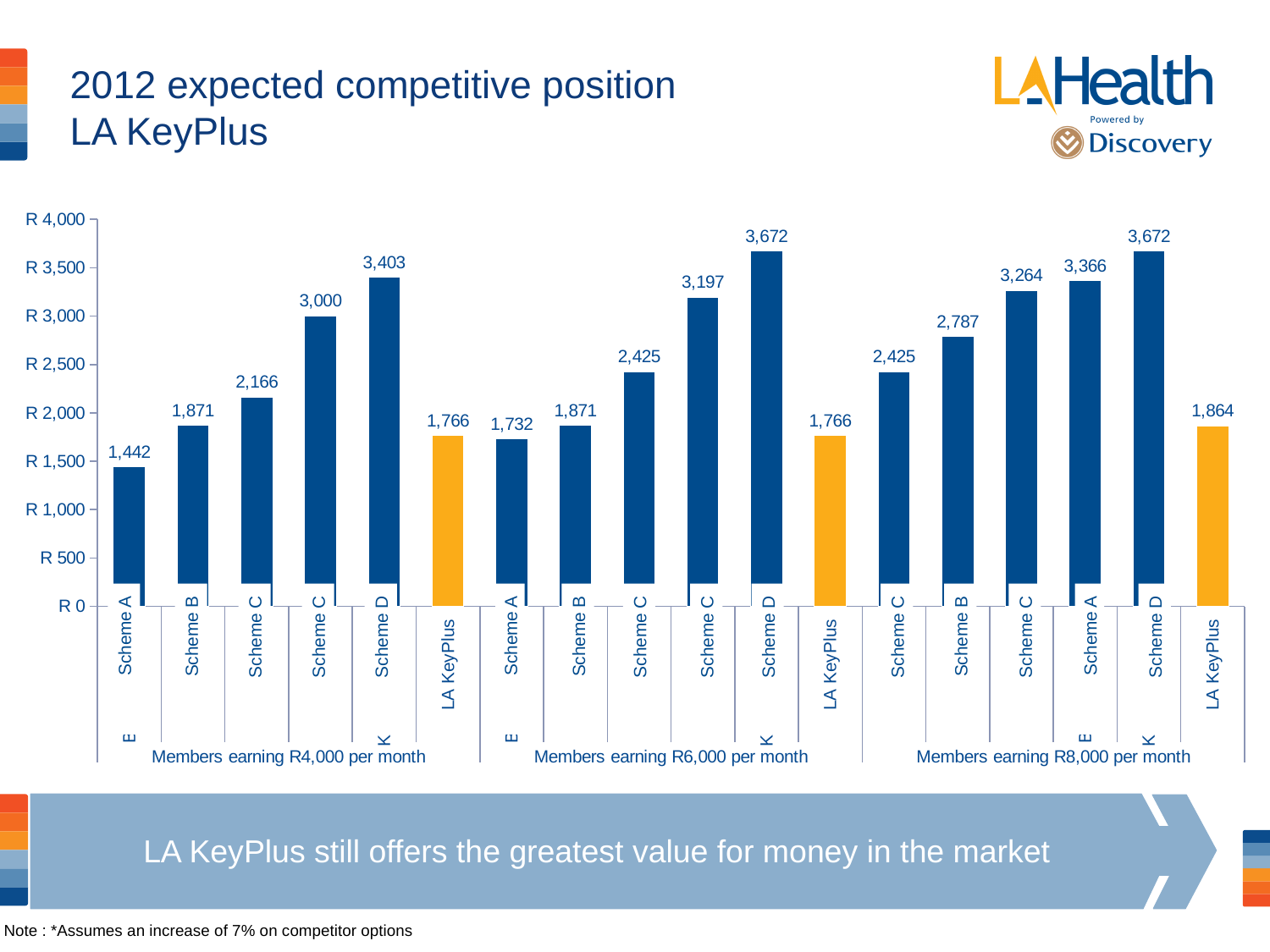
In the 'Members earning R8,000 per month' group, which is larger: Scheme B or LA KeyPlus? Scheme B Which bar has the lowest value in the whole chart? Scheme A (Members earning R4,000 per month), 1,442 What is the value for LA KeyPlus in the 'Members earning R4,000 per month' group? 1,766 What is the value for Scheme A in the 'Members earning R6,000 per month' group? 1,732 What is the value for LA KeyPlus in the 'Members earning R8,000 per month' group? 1,864 How many earnings groups are shown along the x axis? 3 What is the difference between Scheme D and LA KeyPlus in the 'Members earning R4,000 per month' group? 1,637 What kind of chart is shown on the slide? Bar chart What colour are the LA KeyPlus bars? Orange What is the value for Scheme D in the 'Members earning R6,000 per month' group? 3,672 Which scheme has the highest value in the 'Members earning R8,000 per month' group? Scheme D How many bars are plotted in the chart in total? 18